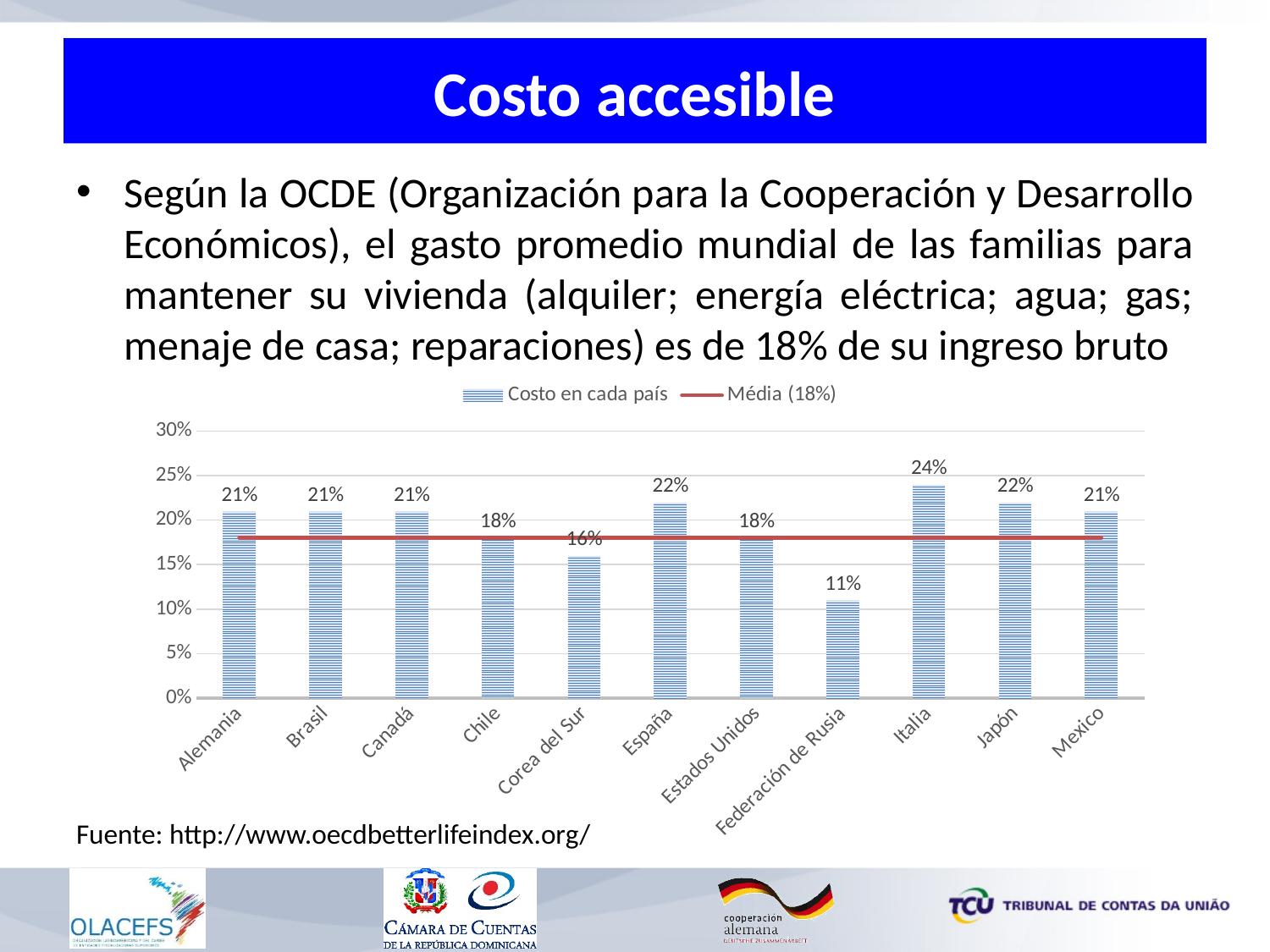
How many series does the legend list? 2 Which is larger, the value for Japón or the value for Chile? Japón How many countries are shown on the x axis? 11 Which country has the highest value? Italia What kind of chart is this? Combination bar and line chart Which country has the lowest value? Federación de Rusia What is the value for España? 22% What is the value for Federación de Rusia? 11% What value does the red line labelled 'Média' represent? 18% What is the value for Corea del Sur? 16% What is the value for Italia? 24% What is the difference between the values for Italia and Federación de Rusia? 13%